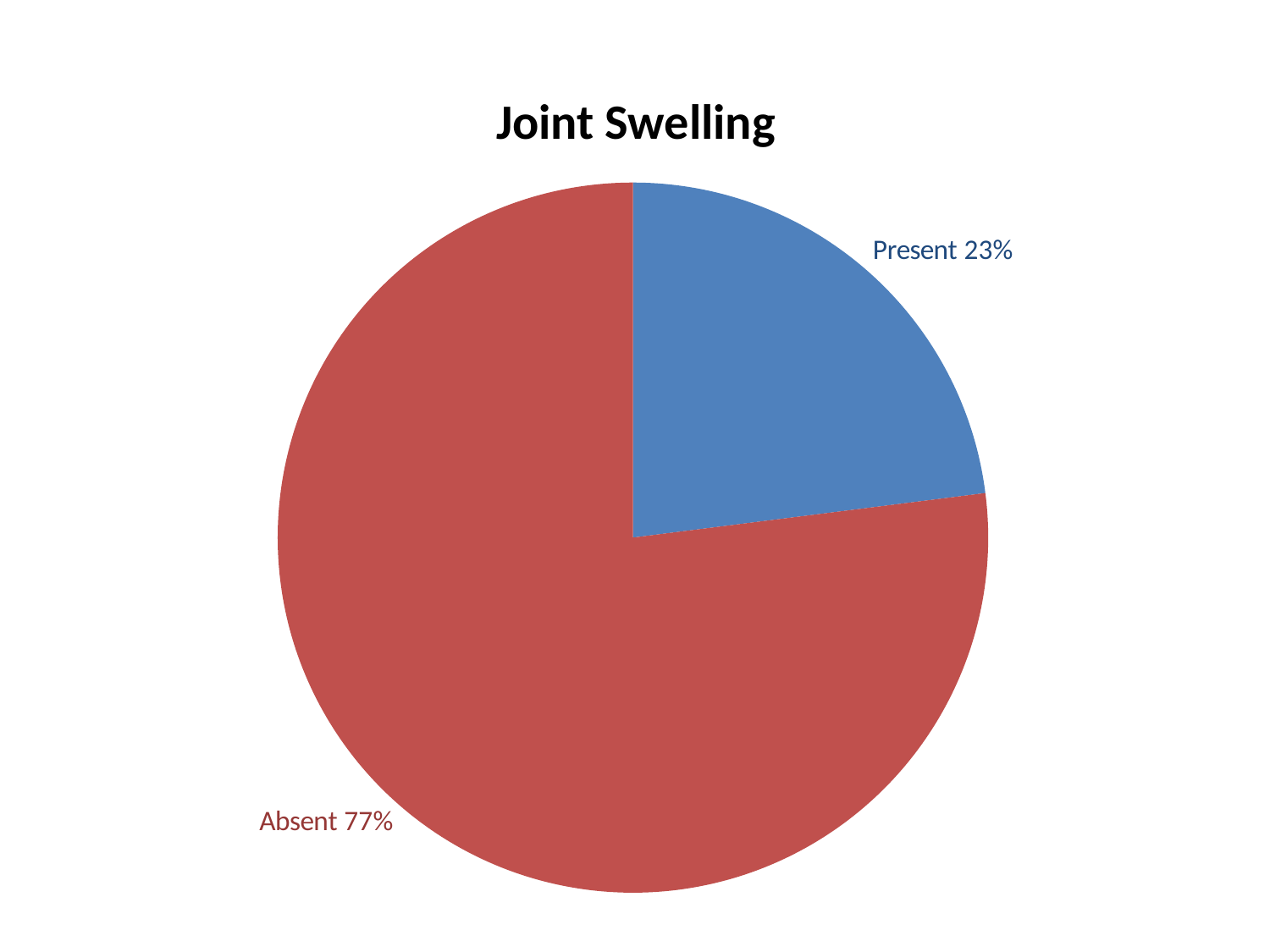
What is the title of the chart? Joint Swelling Which slice is the smallest? Present What kind of chart is shown on the slide? pie chart What percentage of the pie is labelled Present? 23% How many slices does the pie chart have? 2 What percentage of the pie is labelled Absent? 77% What share of the pie does the Present slice represent? 23% What colour is the Absent slice? red Which is larger, the Present slice or the Absent slice? Absent Which slice is the largest? Absent What is the difference in percentage points between the Absent and Present slices? 54